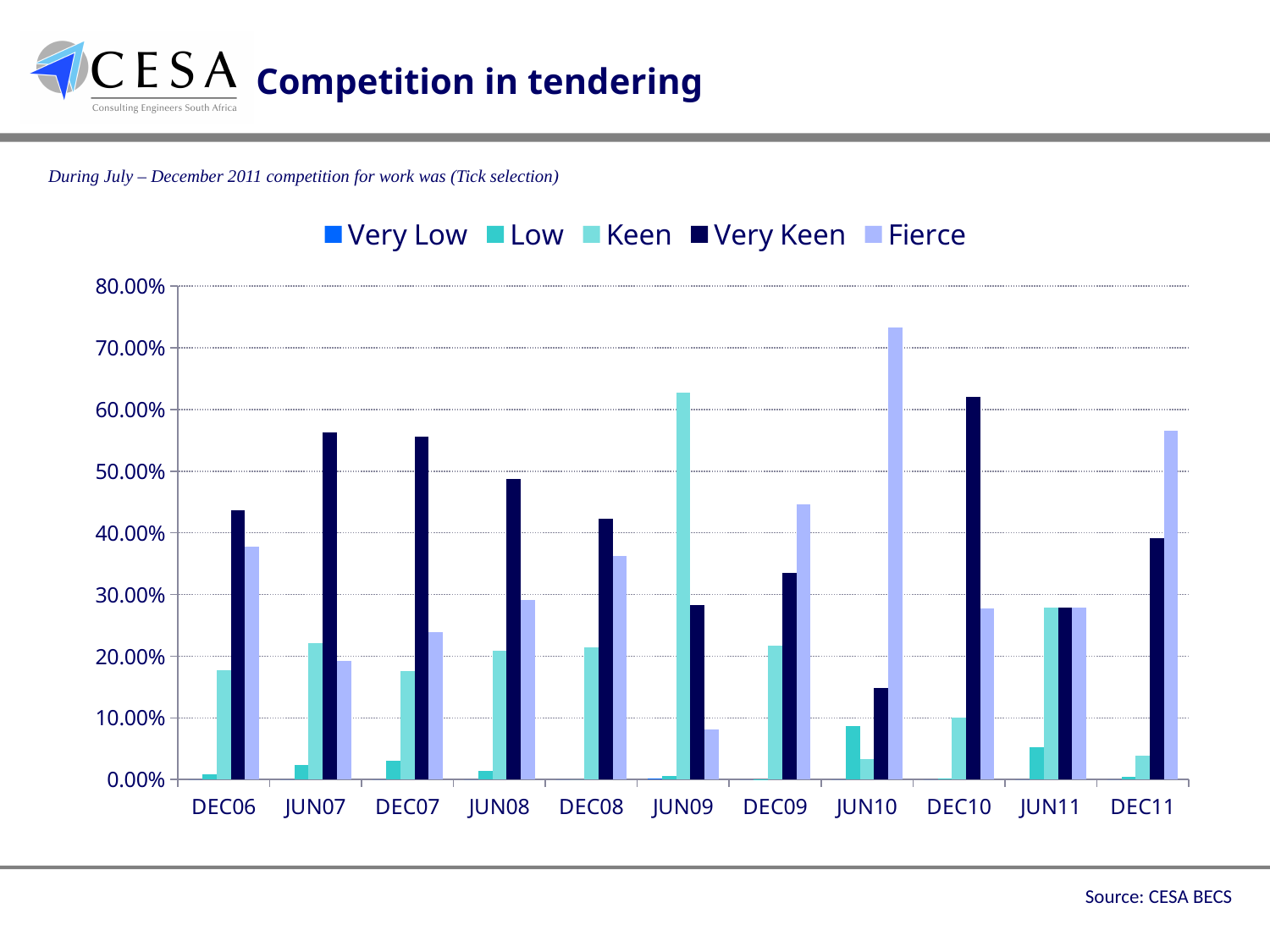
How many series does the legend list? 5 In JUN09, which is larger: Keen or Very Keen? Keen What kind of chart is shown on the slide? bar chart What is the title of the chart on the slide? Competition in tendering In DEC11, which is larger: Fierce or Very Keen? Fierce How many survey periods are shown along the x axis? 11 Is the value for Very Keen in DEC10 greater or less than 60.00%? greater In which period is the Very Keen bar the highest? DEC10 In which period is the Very Keen bar the lowest? JUN10 Is the value for Fierce in JUN10 greater or less than 70.00%? greater In which period is the Fierce bar the highest? JUN10 Is the value for Keen in JUN09 greater or less than 60.00%? greater